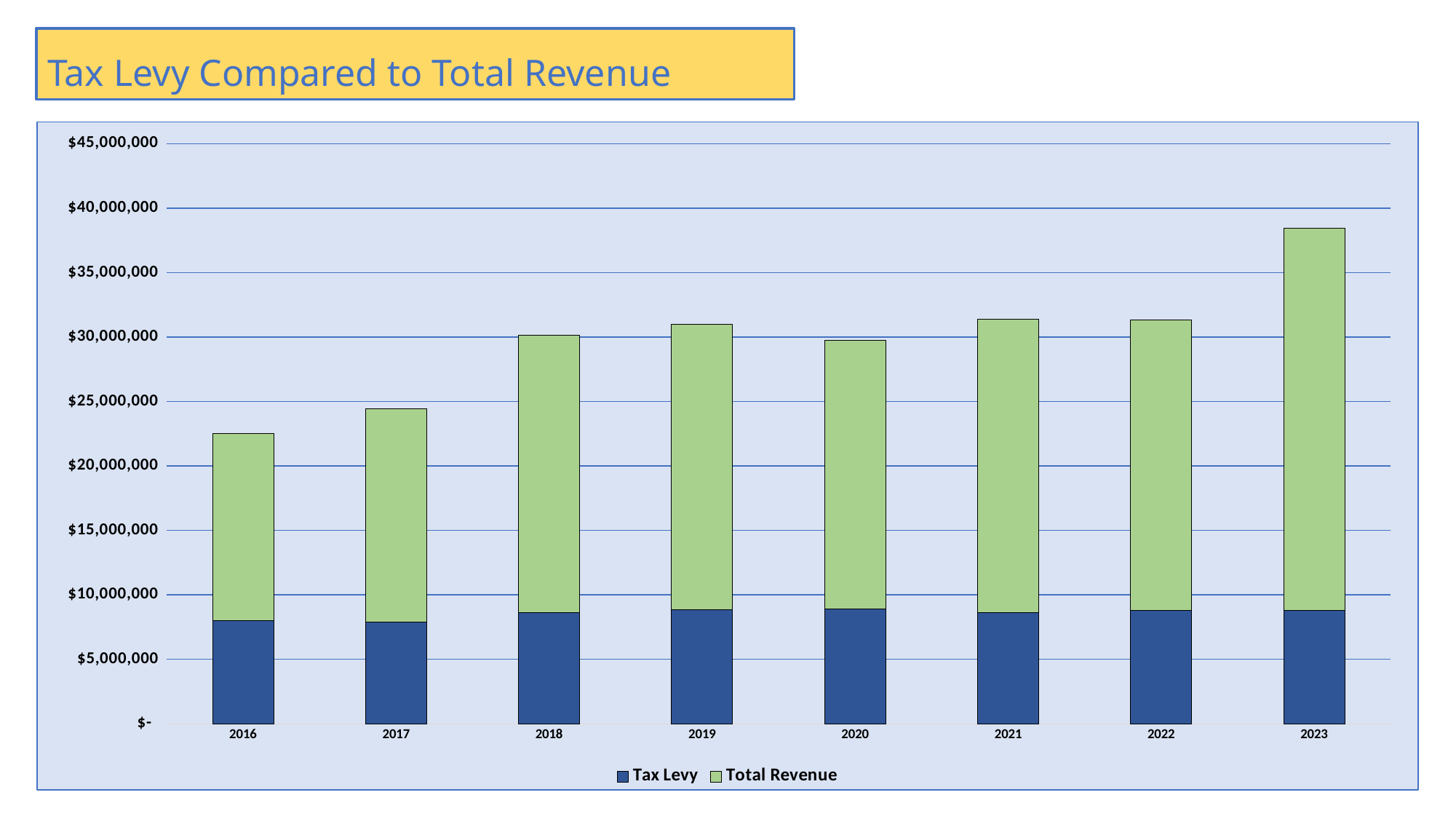
Which year has the tallest stacked bar in the chart? 2023 What are the two series named in the chart's legend? Tax Levy and Total Revenue Is the Tax Levy value for 2019 greater or less than $10,000,000? less What kind of chart is shown on the slide? bar chart Which year has the shortest stacked bar in the chart? 2016 Which year has the taller stacked bar, 2020 or 2021? 2021 How many series does the chart's legend list? 2 Is the top of the stacked bar for 2017 greater or less than $20,000,000? greater Is the top of the stacked bar for 2023 greater or less than $35,000,000? greater How many years are shown on the x axis of the chart? 8 Which year has the taller stacked bar, 2017 or 2018? 2018